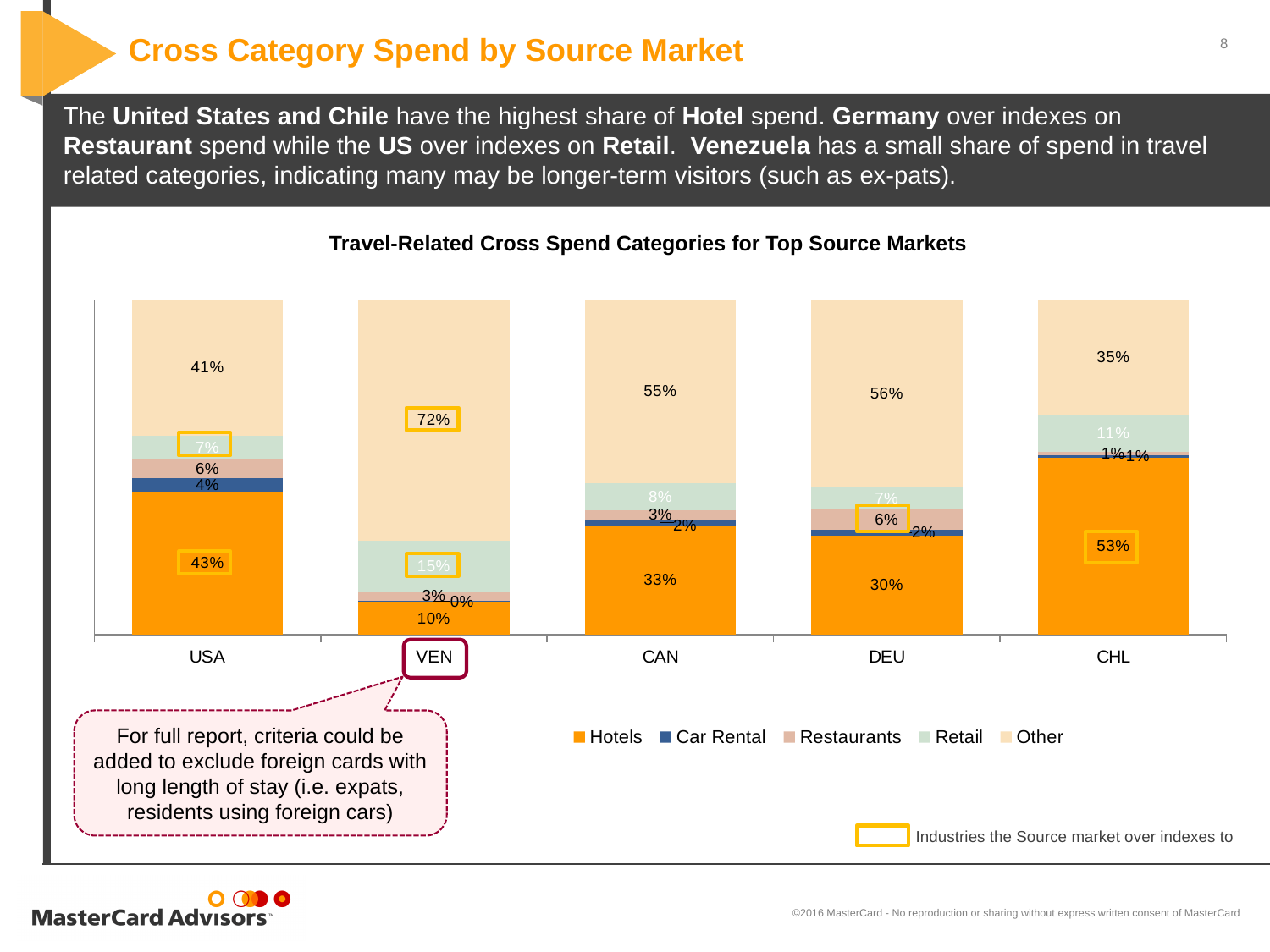
Which source market has the lowest Hotels share? VEN What kind of chart is shown? Stacked bar chart How many source markets are shown on the x axis? 5 Which source market has the highest Hotels share? CHL What is the Retail share for CHL? 11% What is the Restaurants share for DEU? 6% What is the difference between the Other share for VEN and the Other share for CHL? 37% What is the Other share for VEN? 72% Which is larger, the Hotels share for CAN or the Hotels share for DEU? CAN What is the title of the chart? Travel-Related Cross Spend Categories for Top Source Markets How many series does the legend list? 5 What is the Hotels share for USA? 43%